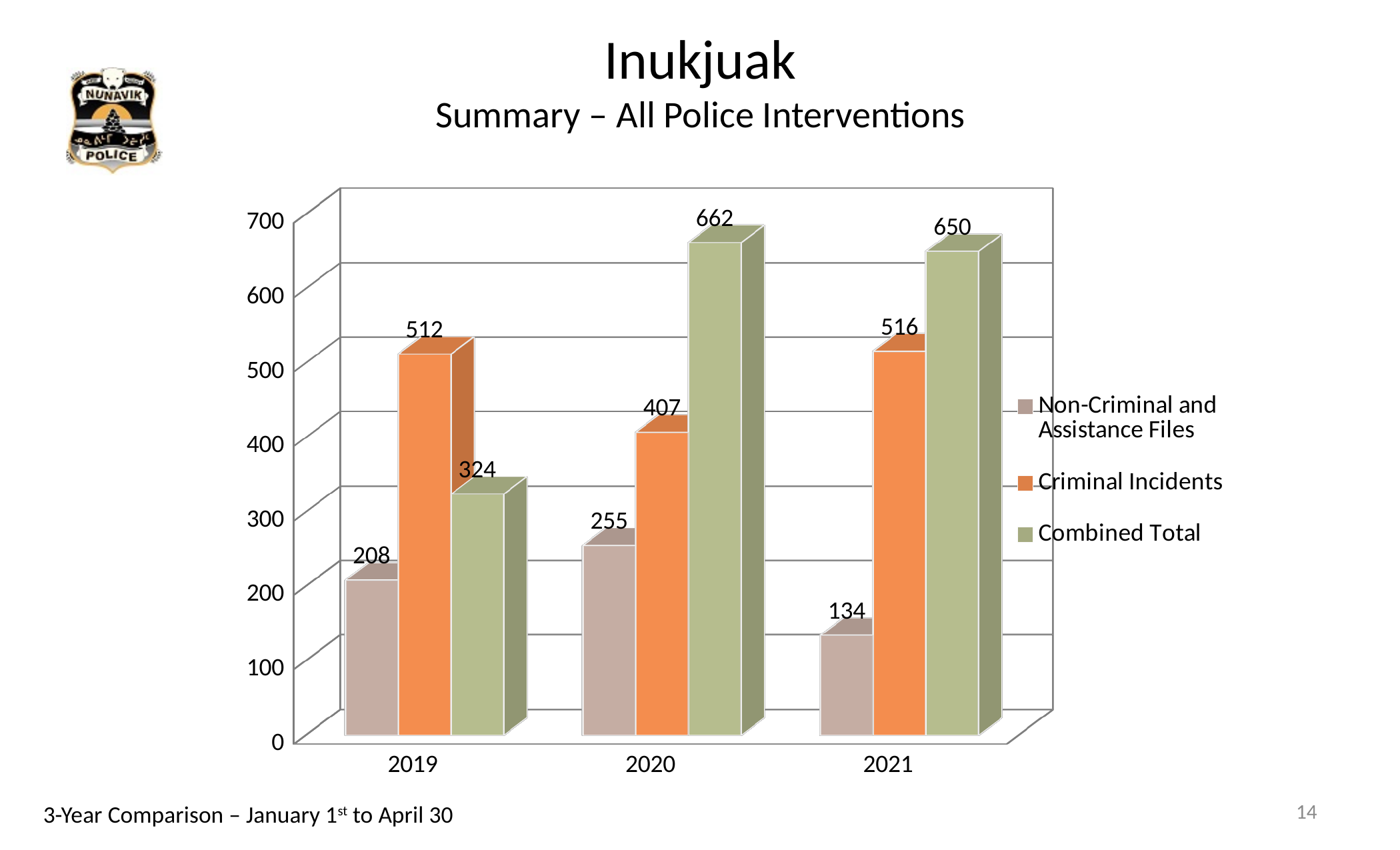
Is the value for Criminal Incidents in 2021 greater or less than 400? greater What is the value for Criminal Incidents in 2019? 512 How many years are shown on the x axis? 3 Which is larger, Criminal Incidents in 2019 or Criminal Incidents in 2020? 2019 What is the difference between the Combined Total in 2020 and in 2019? 338 Which year has the highest Combined Total? 2020 Which year has the lowest value for Non-Criminal and Assistance Files? 2021 Do the values for Non-Criminal and Assistance Files rise or fall from 2020 to 2021? fall How many series does the legend list? 3 What is the Combined Total for 2020? 662 What kind of chart is shown on the slide? bar chart What is the value for Non-Criminal and Assistance Files in 2021? 134